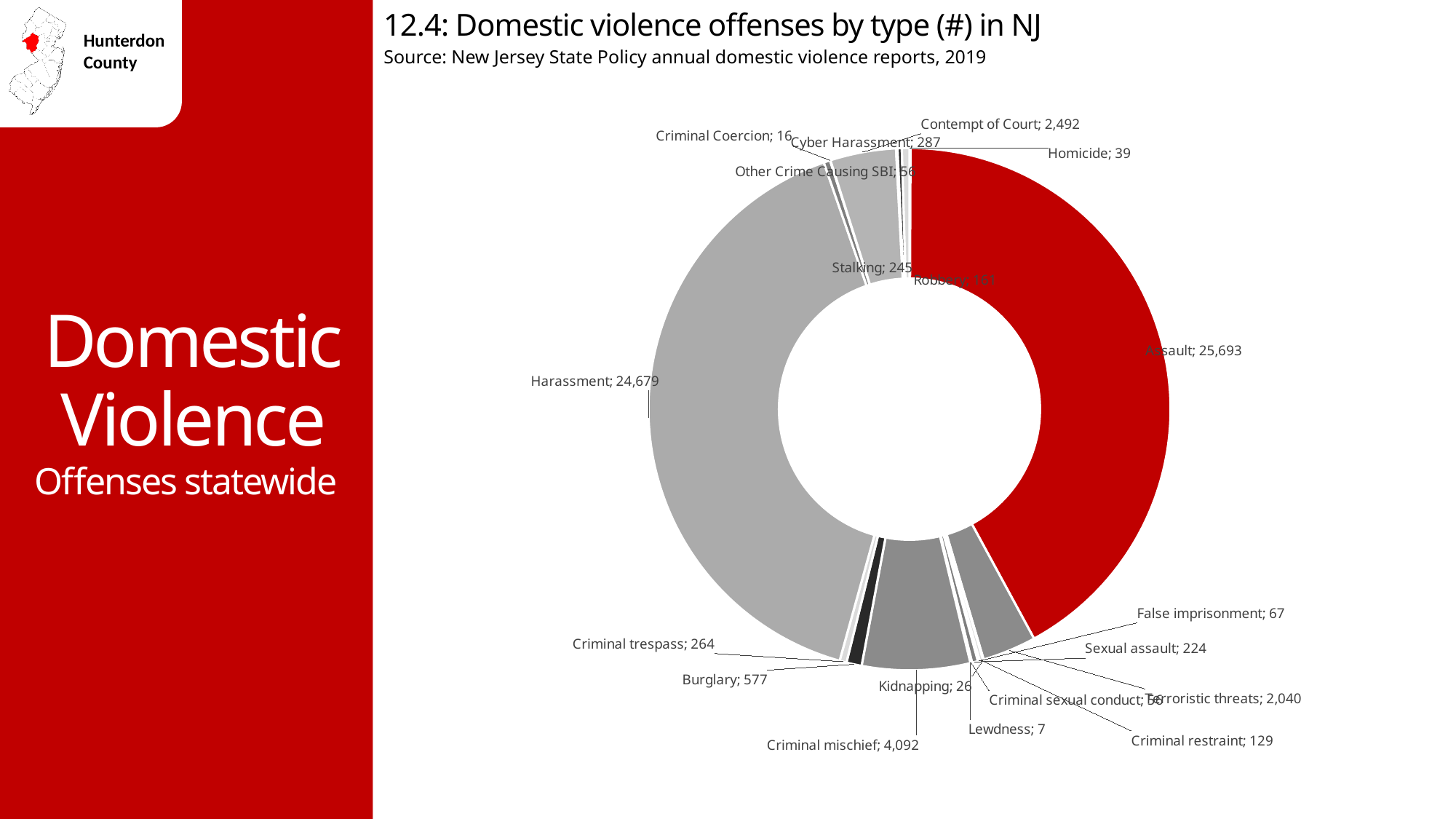
What is the value for Contempt of Court? 2,492 What is the value for Harassment? 24,679 What kind of chart is shown on the slide? doughnut chart How many domestic violence offenses of type Assault are shown? 25,693 What is the value for Burglary? 577 Which offense type has the lowest number of offenses? Lewdness What is the value for Lewdness? 7 Which is larger, Contempt of Court or Terroristic threats? Contempt of Court What is the difference between the values for Assault and Harassment? 1,014 What is the value for Criminal mischief? 4,092 Which offense type has the highest number of offenses? Assault What colour is the Assault slice of the chart? red